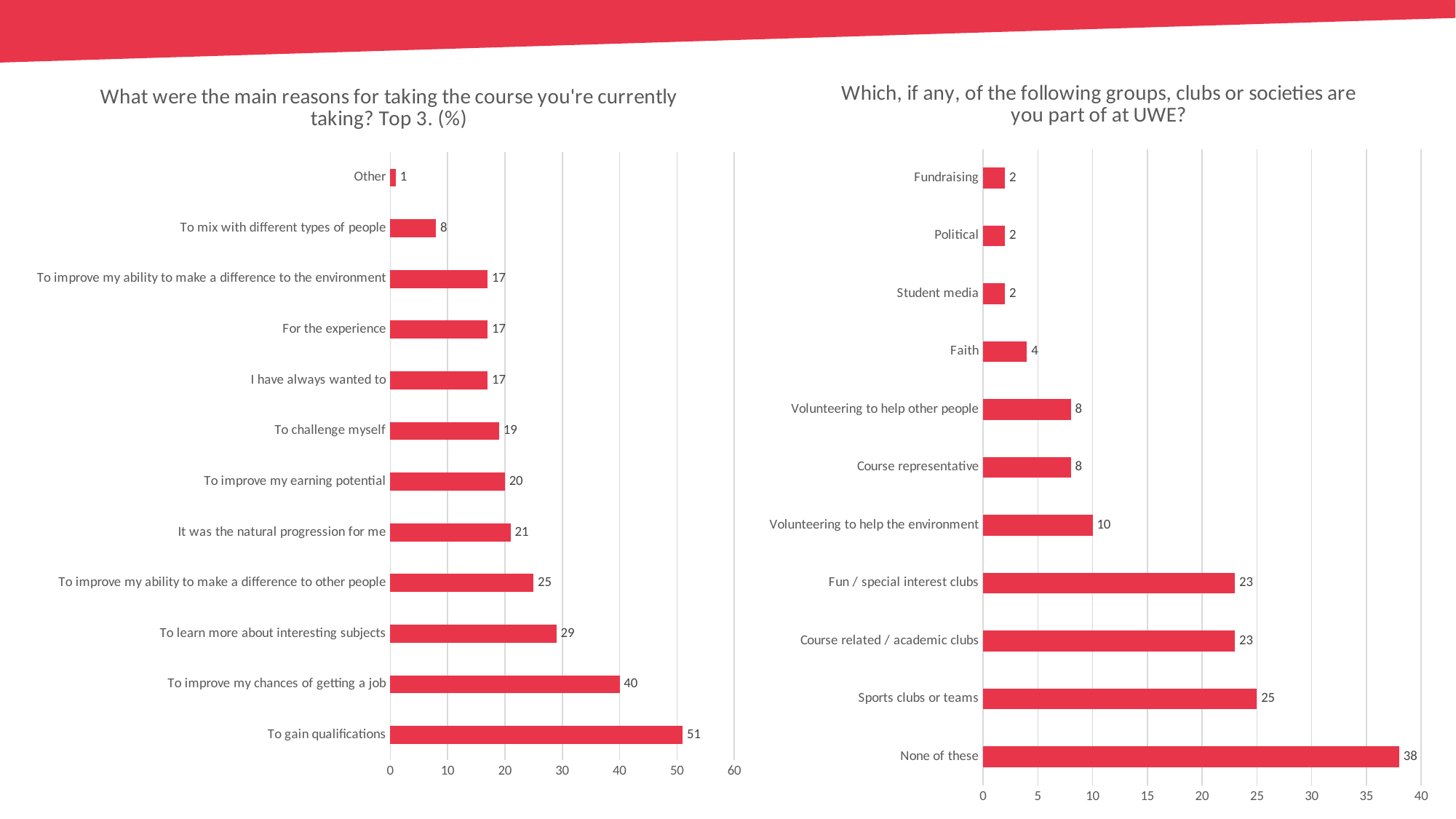
In the left chart (main reasons for taking the course), what is the difference between 'To improve my chances of getting a job' and 'To learn more about interesting subjects'? 11 What type of chart is the left chart (main reasons for taking the course)? Bar chart In the right chart (groups, clubs or societies at UWE), what is the value for 'Sports clubs or teams'? 25 In the left chart (main reasons for taking the course), what is the value for 'To improve my earning potential'? 20 In the left chart (main reasons for taking the course), what is the value for 'To gain qualifications'? 51 In the right chart (groups, clubs or societies at UWE), which category has the highest value? None of these In the right chart (groups, clubs or societies at UWE), how many categories are shown? 11 In the right chart (groups, clubs or societies at UWE), what is the difference between 'None of these' and 'Sports clubs or teams'? 13 In the right chart (groups, clubs or societies at UWE), which is larger: 'Faith' or 'Volunteering to help the environment'? Volunteering to help the environment What is the title of the right chart? Which, if any, of the following groups, clubs or societies are you part of at UWE? In the left chart (main reasons for taking the course), which category has the lowest value? Other In the left chart (main reasons for taking the course), how many categories are shown? 12